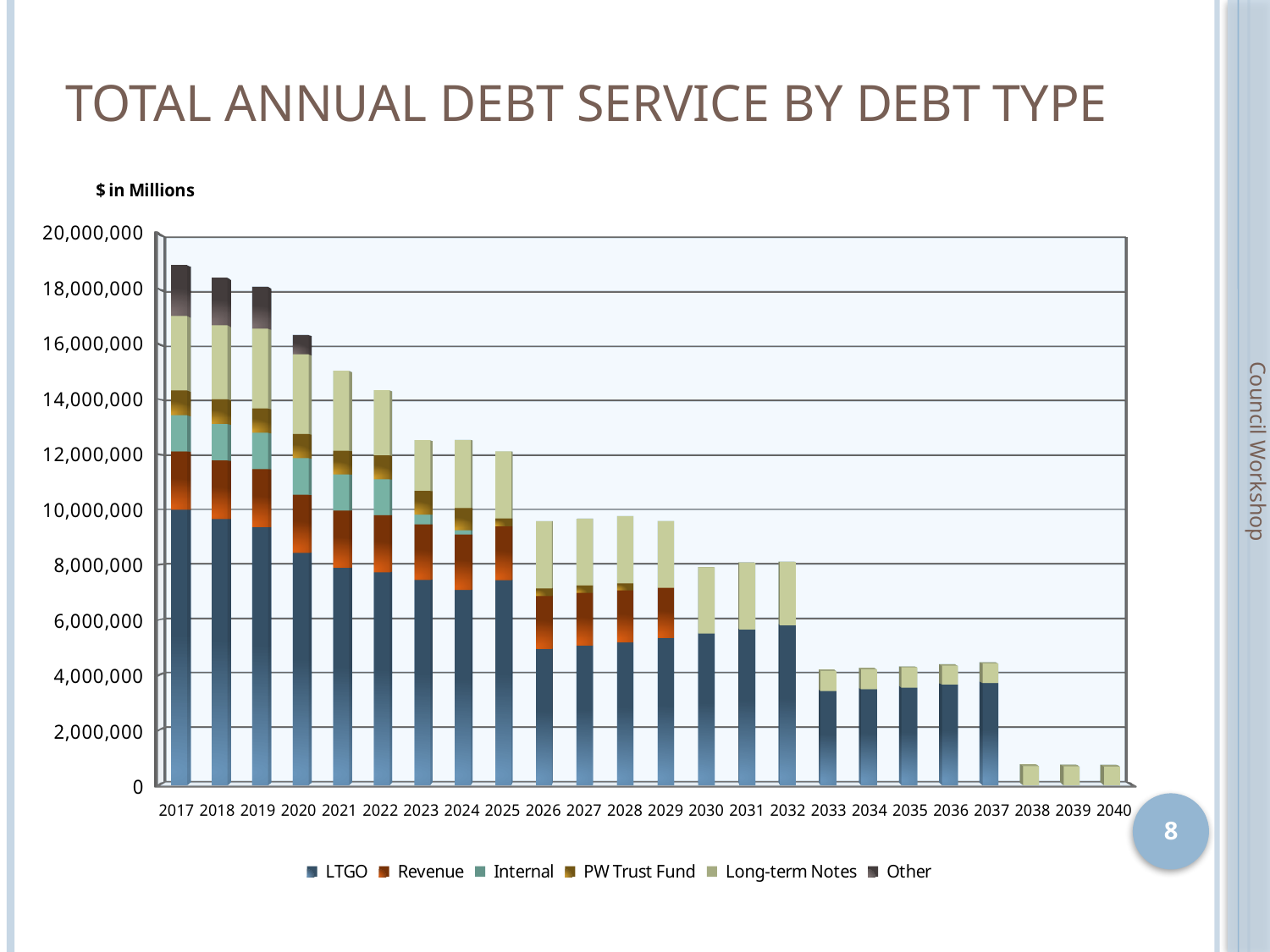
Is the total for 2038 greater or less than 2,000,000? less What kind of chart is shown on the slide? Stacked bar chart Which year has the larger total, 2032 or 2033? 2032 How many series does the legend list? 6 Which year has the larger total, 2017 or 2020? 2017 Is the total for 2021 greater or less than 14,000,000? greater Do the total bar heights generally rise or fall from 2017 to 2040? fall Is the total for 2017 greater or less than 18,000,000? greater What is the title of the chart? TOTAL ANNUAL DEBT SERVICE BY DEBT TYPE How many years are shown along the x axis? 24 Which year has the highest total annual debt service? 2017